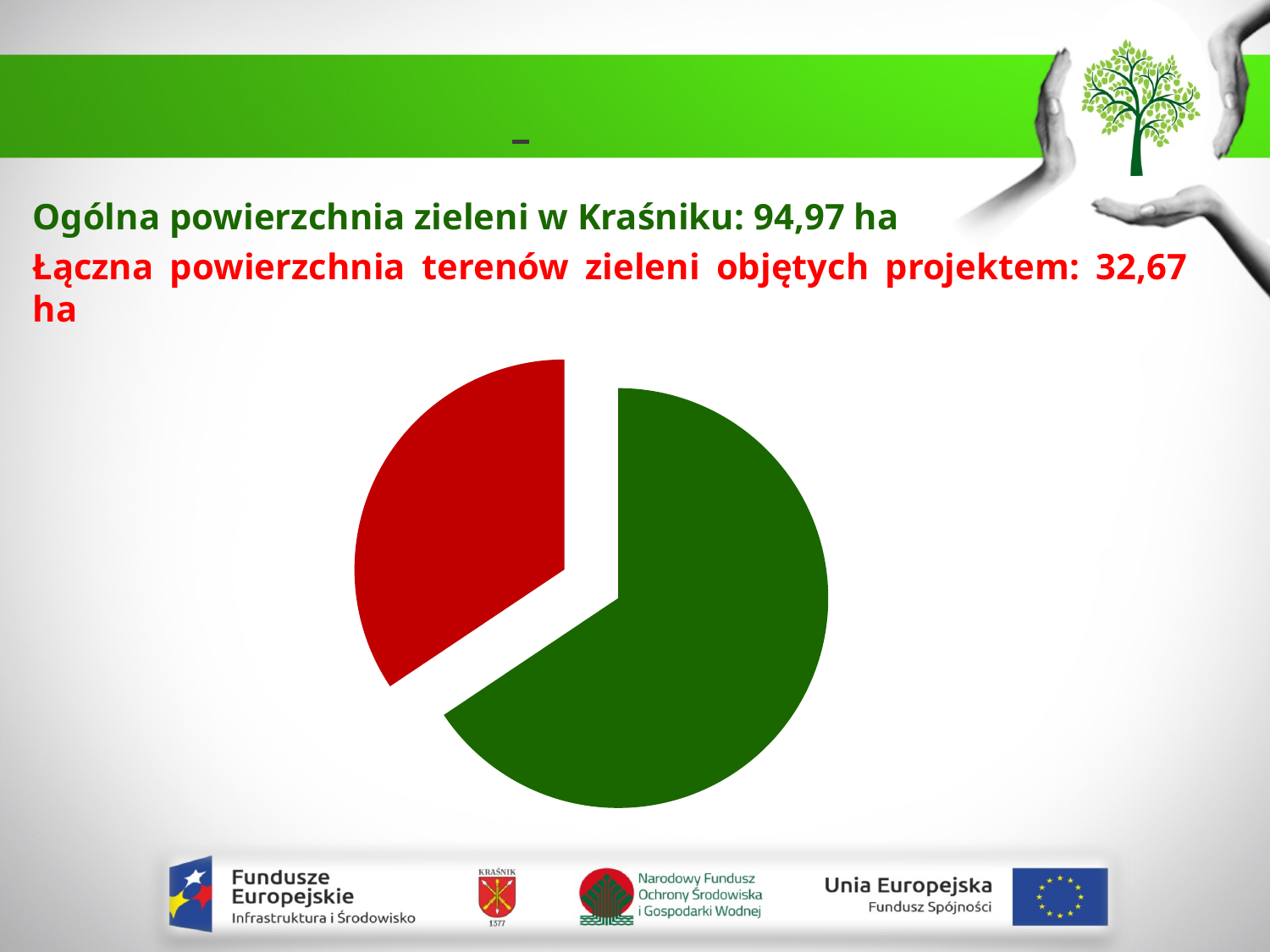
Does the red slice take up more or less than half of the pie chart? less Which slice of the pie chart is larger, the green one or the red one? green Does the pie chart display a legend? no Does the green slice take up more or less than half of the pie chart? more Which slice of the pie chart is the smallest? the red slice What kind of chart is shown on the slide? pie chart What two colours are used for the slices of the pie chart? red and green Which slice of the pie chart is the largest? the green slice How many slices does the pie chart have? 2